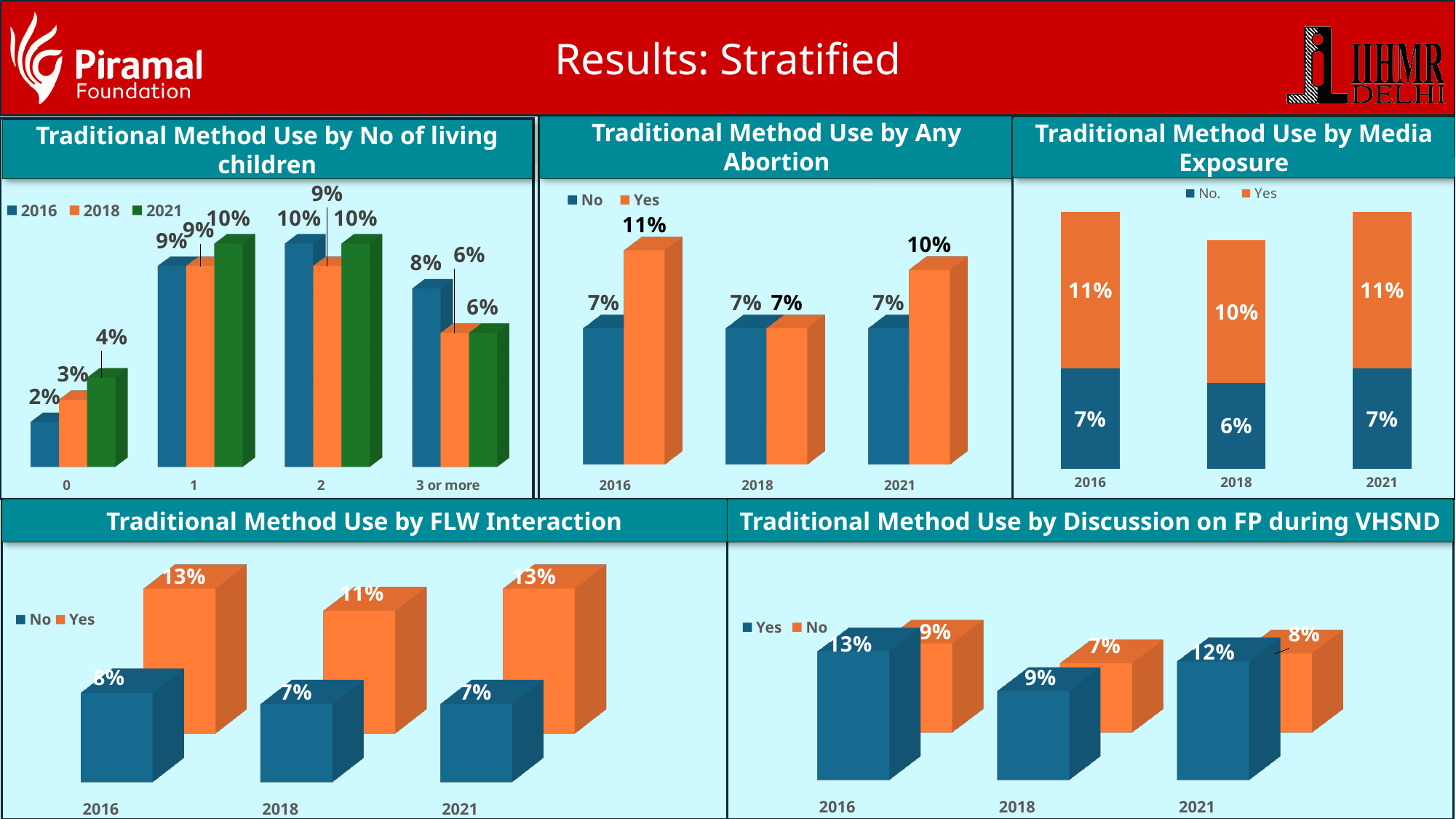
In the 'Traditional Method Use by Any Abortion' chart, what is the difference between the 'Yes' and 'No' values for 2021? 3% In the 'Traditional Method Use by No of living children' chart, how many series does the legend list? 3 In the 'Traditional Method Use by Any Abortion' chart, what is the 'Yes' value for 2016? 11% What kind of chart is 'Traditional Method Use by Discussion on FP during VHSND'? Bar chart In the 'Traditional Method Use by FLW Interaction' chart, which year has the lowest 'Yes' value? 2018 In the 'Traditional Method Use by No of living children' chart, what is the 2016 value for 3 or more living children? 8% In the 'Traditional Method Use by No of living children' chart, what is the 2021 value for 0 living children? 4% In the 'Traditional Method Use by FLW Interaction' chart, what is the 'No' value for 2016? 8% In the 'Traditional Method Use by Media Exposure' chart, what is the total of the stacked bar for 2018? 16% In the 'Traditional Method Use by No of living children' chart, how many categories are shown on the x axis? 4 In the 'Traditional Method Use by Discussion on FP during VHSND' chart, which is larger for 2016, the 'Yes' value or the 'No' value? Yes In the 'Traditional Method Use by Media Exposure' chart, what is the 'No.' value for 2016? 7%